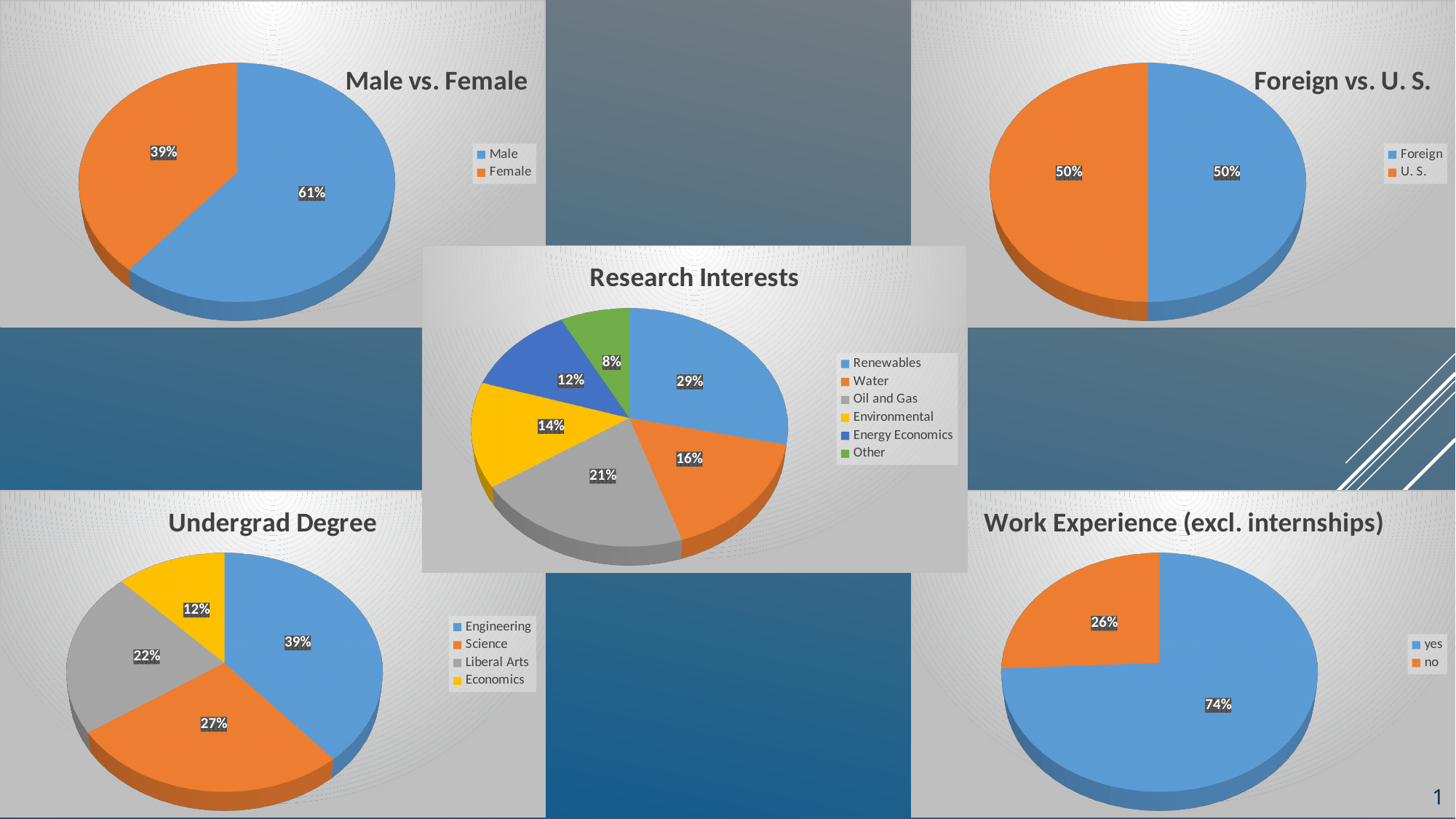
In the Research Interests chart, which category has the largest share? Renewables In the Foreign vs. U. S. chart, what percentage is Foreign? 50% In the Male vs. Female chart, what percentage is Male? 61% What kind of chart is the Undergrad Degree chart? Pie chart In the Work Experience (excl. internships) chart, which is larger, yes or no? yes In the Research Interests chart, which category has the smallest share? Other In the Research Interests chart, how many categories does the legend list? 6 In the Work Experience (excl. internships) chart, what percentage answered yes? 74% In the Research Interests chart, what percentage is Oil and Gas? 21% In the Undergrad Degree chart, what percentage is Liberal Arts? 22% In the Undergrad Degree chart, what is the difference between Engineering and Science? 12% In the Male vs. Female chart, what percentage is Female? 39%